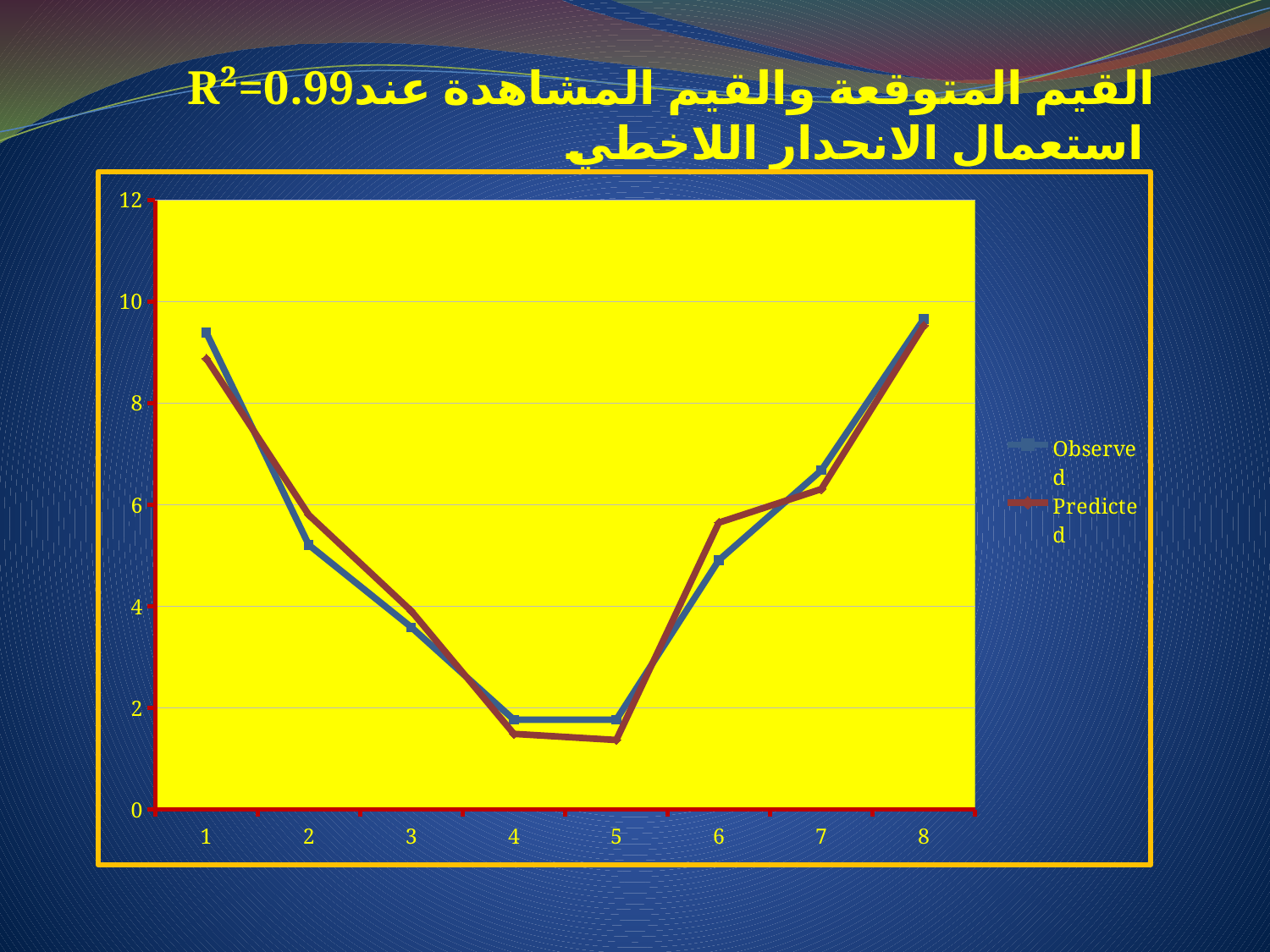
Is the Observed value at point 7 greater or less than 6? greater How many series does the legend list? 2 At point 2, which series has the higher value, Observed or Predicted? Predicted At point 1, which series has the higher value, Observed or Predicted? Observed Do the Observed values rise or fall from point 1 to point 4? fall Which series are listed in the legend? Observed and Predicted Is the Observed value at point 1 greater or less than 8? greater Is the Observed value at point 6 greater or less than 6? less What kind of chart is shown on the slide? line chart At which x-axis point does the Predicted series reach its highest value? 8 How many points are plotted along the x axis for each series? 8